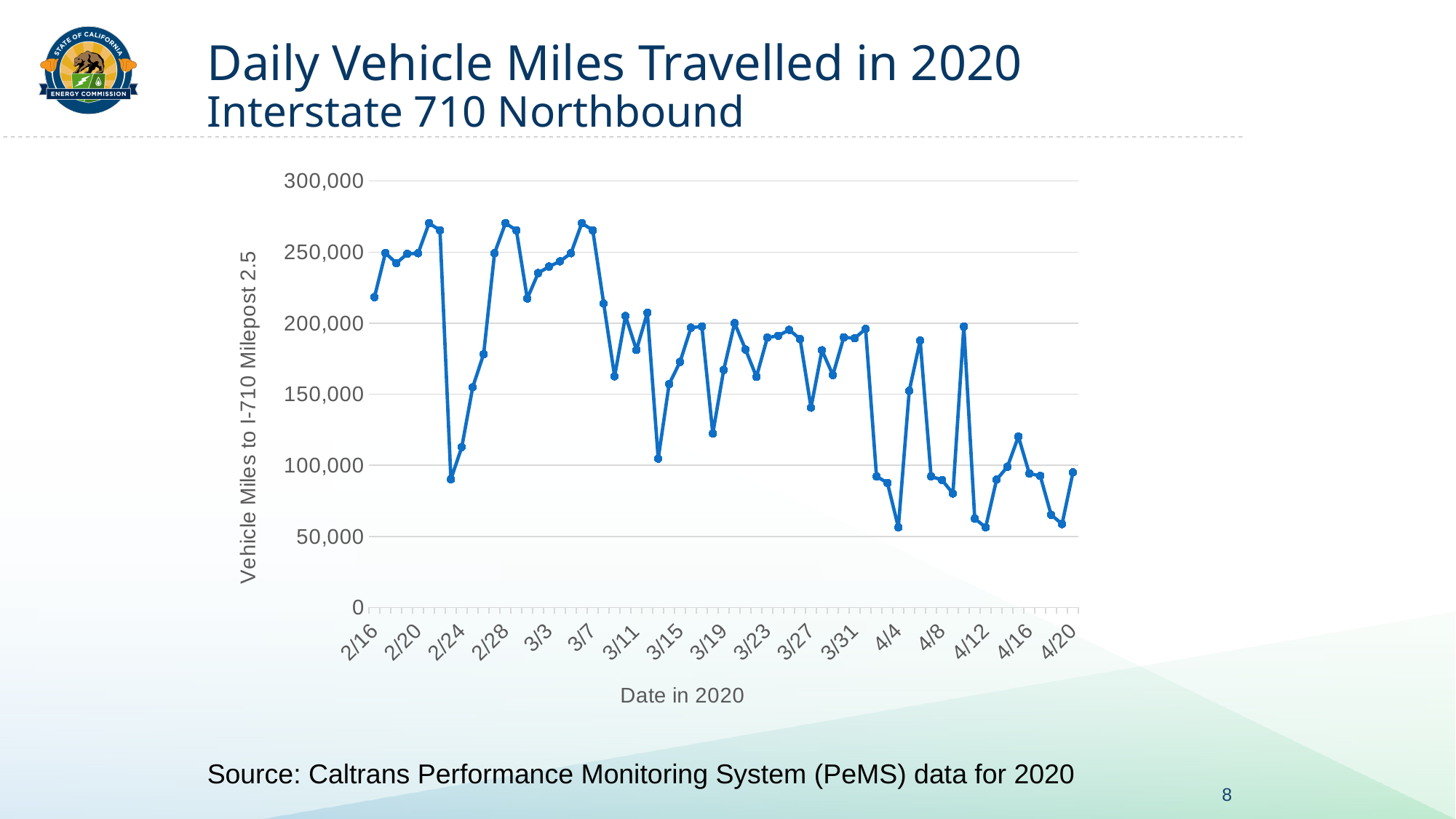
Is the value for 3/19 greater or less than 150,000? greater Which is larger, the value for 2/28 or the value for 4/16? 2/28 What kind of chart is shown on the slide? line chart Is the value for 2/24 greater or less than 100,000? greater Is the value for 4/12 greater or less than 100,000? less Which is larger, the value for 3/23 or the value for 4/8? 3/23 What is the label on the vertical axis of the chart? Vehicle Miles to I-710 Milepost 2.5 What is the label on the horizontal axis of the chart? Date in 2020 Overall, do the daily vehicle miles travelled rise or fall from 2/16 to 4/20? fall